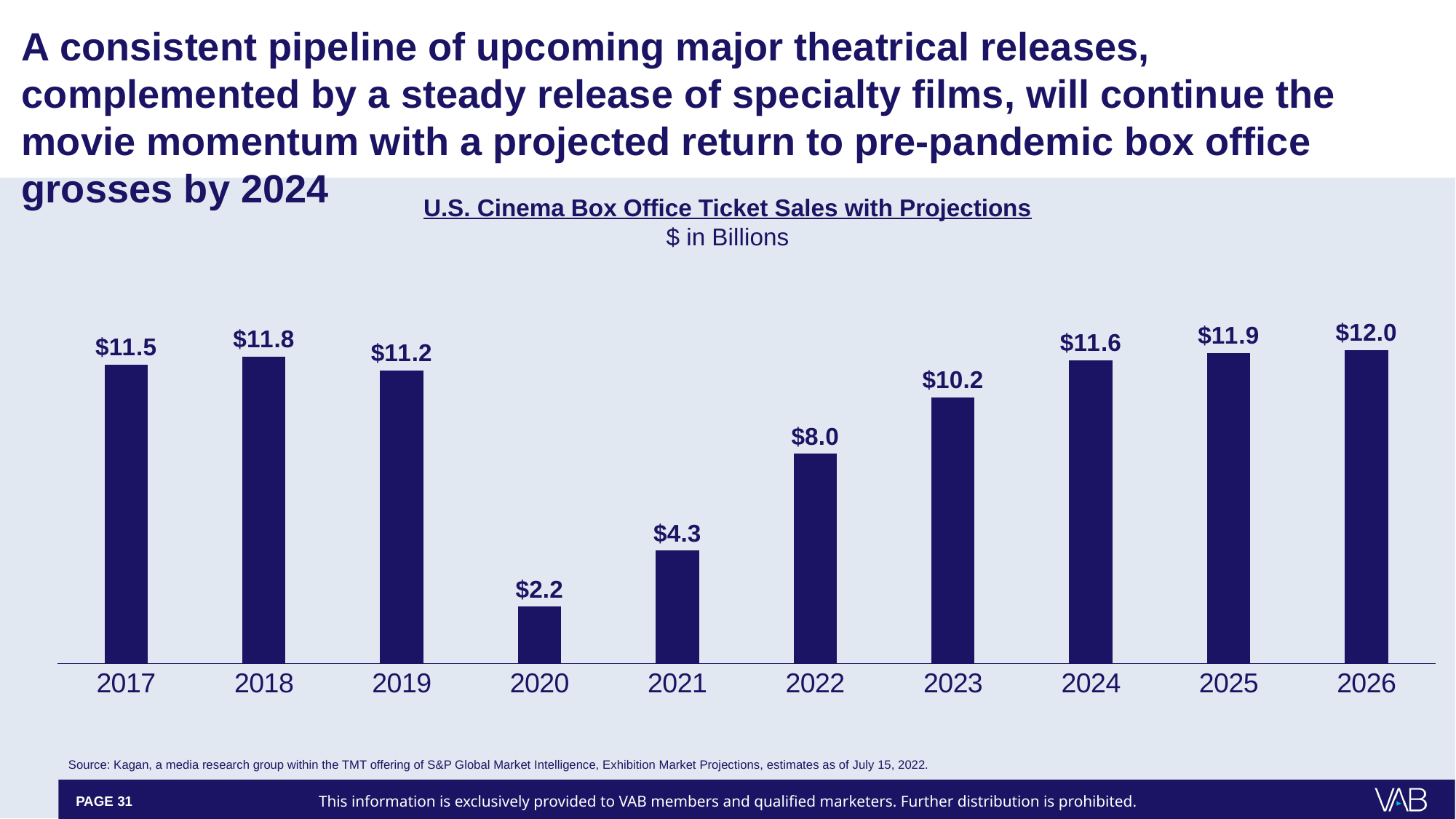
What is the difference between the values for 2019 and 2020? $9.0 Do the values rise or fall from 2020 to 2026? rise Which year has the lowest value? 2020 What is the difference between the values for 2026 and 2022? $4.0 Which year has the highest value? 2026 Which is larger, the value for 2021 or the value for 2022? 2022 What kind of chart is this? bar chart What is the value for 2023? $10.2 What is the value for 2020? $2.2 What is the title of the chart? U.S. Cinema Box Office Ticket Sales with Projections What is the value for 2018? $11.8 How many years are shown on the x axis? 10